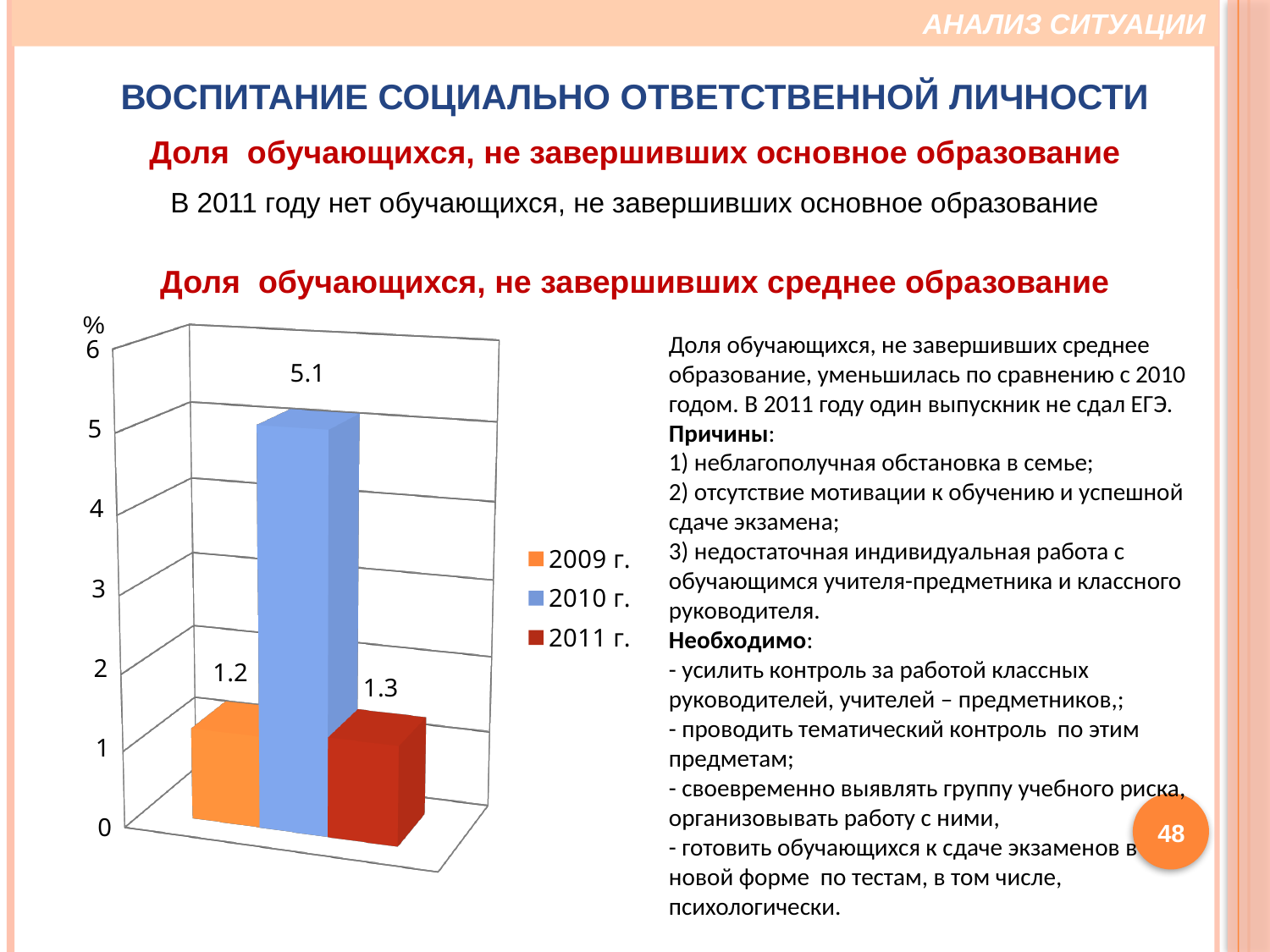
What is the value for 2010 г. in the chart? 5.1 Which year has the lowest value in the chart? 2009 г. Is the value for 2010 г. greater or less than 5? greater How many series does the legend list? 3 What is the difference between the values for 2010 г. and 2011 г.? 3.8 What is the difference between the values for 2011 г. and 2009 г.? 0.1 Which year has the highest value in the chart? 2010 г. What is the value for 2011 г. in the chart? 1.3 Which is larger, the value for 2010 г. or the value for 2009 г.? 2010 г. What is the value for 2009 г. in the chart? 1.2 What unit is shown on the vertical axis of the chart? % What kind of chart is shown on the slide? bar chart